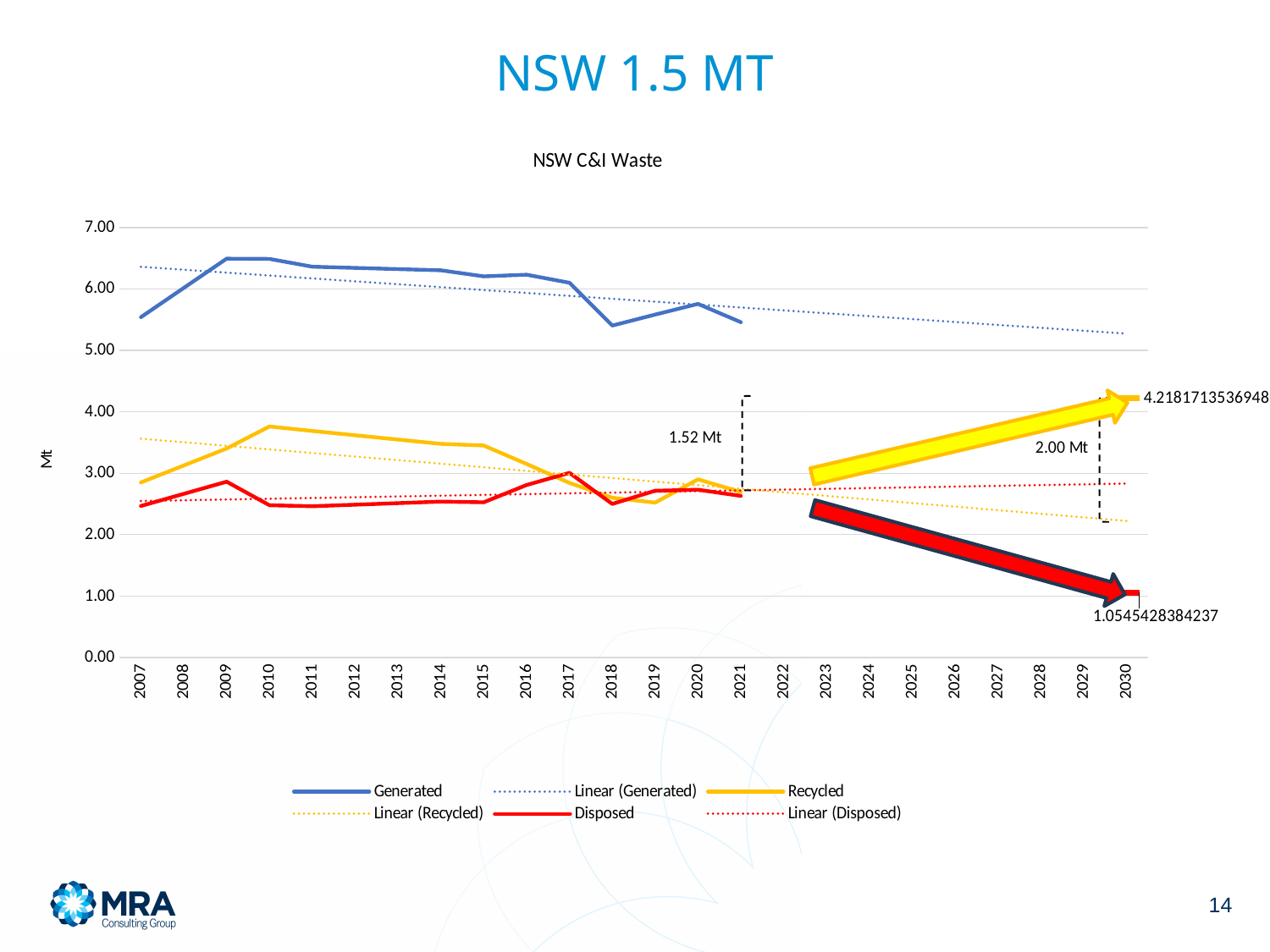
What kind of chart is shown on the slide? line chart What value is printed at the end of the red arrow in 2030? 1.0545428384237 Is the Generated value for 2009 greater or less than 6.00? greater Which is larger in 2015, the Generated value or the Recycled value? Generated In which year is the Recycled series at its highest? 2010 What is the title of the chart? NSW C&I Waste What value is printed at the end of the yellow arrow in 2030? 4.2181713536948 Is the Recycled value for 2010 greater or less than 3.00? greater Does the Linear (Generated) trend line rise or fall from 2007 to 2030? fall How many series does the chart legend list? 6 Is the Generated value for 2018 greater or less than 6.00? less What is the label on the vertical axis of the chart? Mt